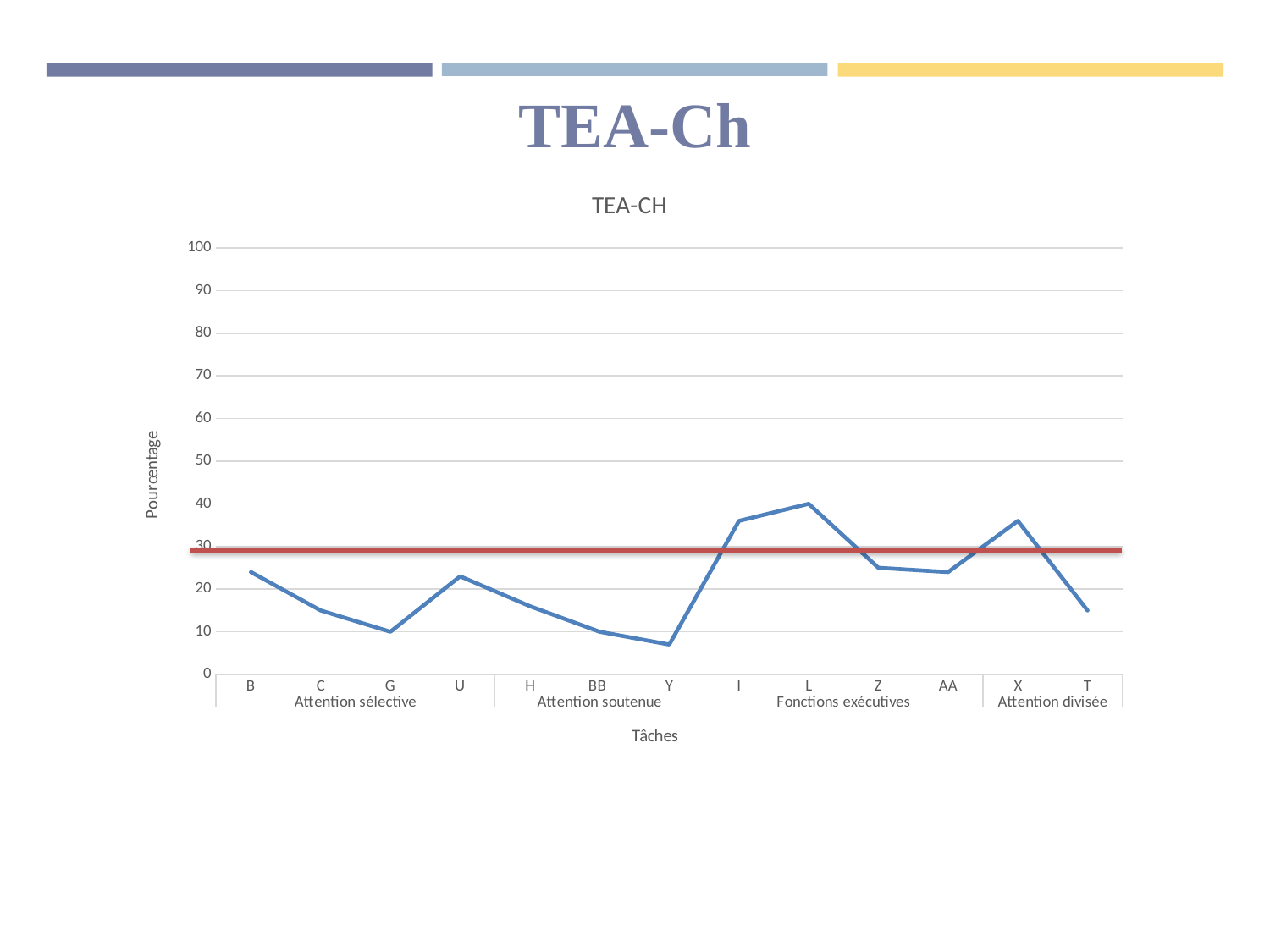
Is the value for I greater or less than 30? greater Which task has the lowest value? Y Is the value for T greater or less than 20? less Do the values rise or fall from X to T? fall Is the value for Z greater or less than 30? less How many task categories are plotted along the x axis? 13 Which task has the highest value? L What is the title of the y axis? Pourcentage Which is larger, the value for X or the value for T? X What kind of chart is shown on the slide? line chart